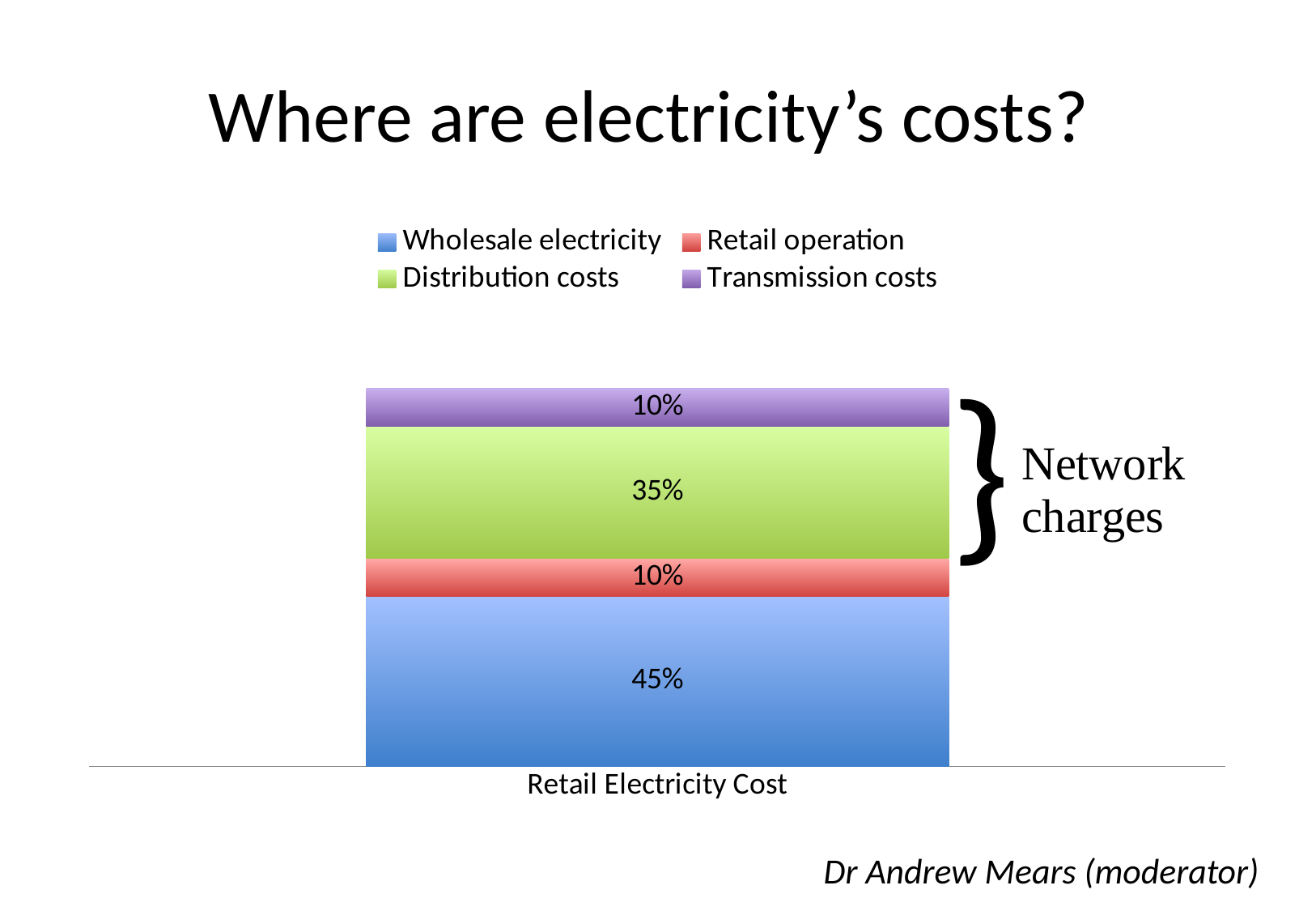
How many series does the legend list? 4 Which series makes up the largest share of the Retail Electricity Cost bar? Wholesale electricity What percentage of the Retail Electricity Cost is Wholesale electricity? 45% What kind of chart is shown on the slide? Stacked bar chart Which two series are grouped under the label 'Network charges'? Distribution costs and Transmission costs What percentage of the Retail Electricity Cost is Retail operation? 10% Which is larger, the Distribution costs share or the Transmission costs share? Distribution costs What percentage of the Retail Electricity Cost is Transmission costs? 10% What is the difference between the Wholesale electricity share and the Distribution costs share? 10% What is the combined share of Distribution costs and Transmission costs (the Network charges)? 45% What percentage of the Retail Electricity Cost is Distribution costs? 35% What is the total of the Retail Electricity Cost stacked bar? 100%